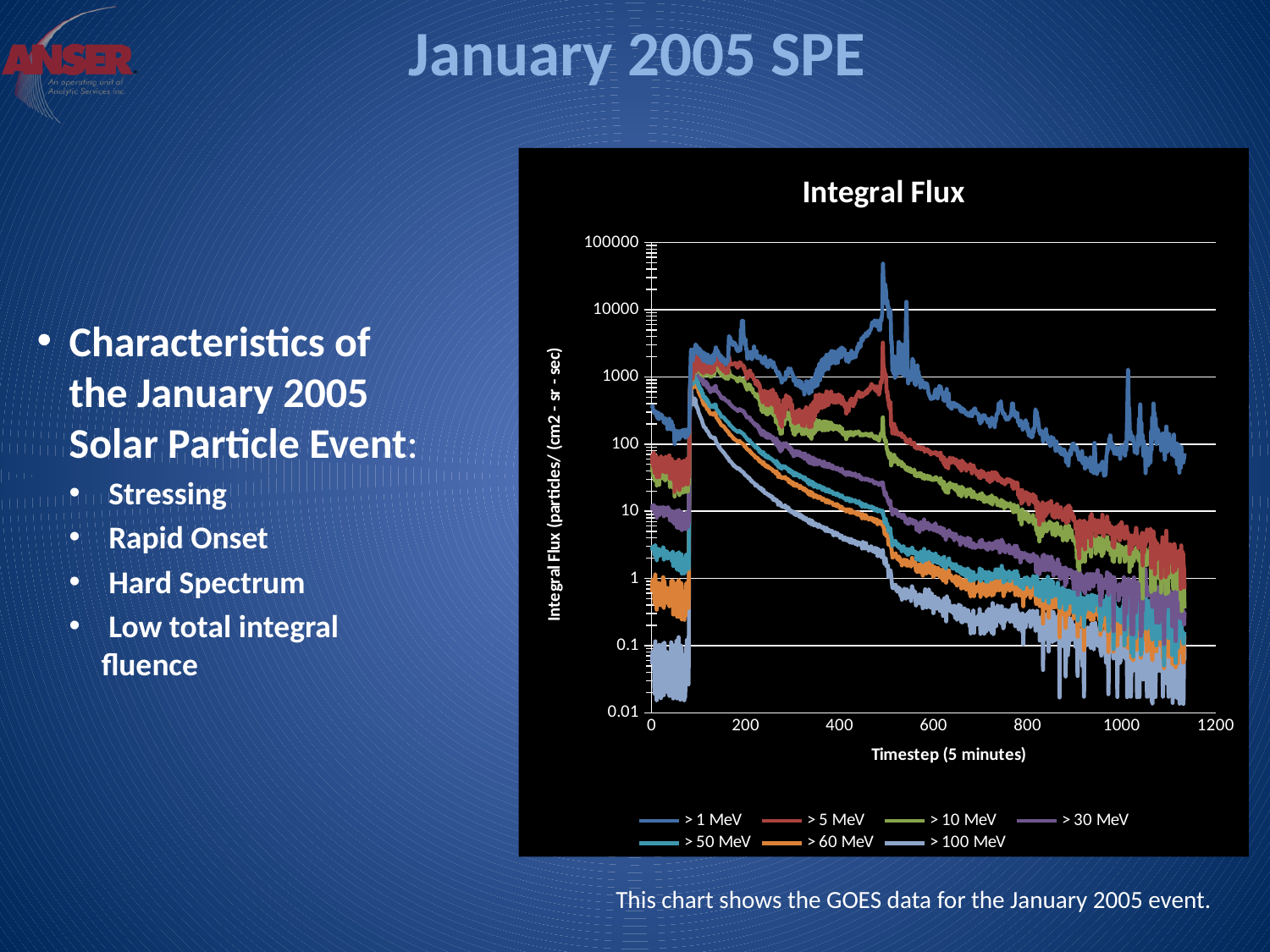
What kind of chart is shown on the slide? line chart Which series in the Integral Flux chart has the lowest values across the event? > 100 MeV Which series in the Integral Flux chart has the highest values across the event? > 1 MeV In the Integral Flux chart, is the value of the > 1 MeV series at timestep 200 greater or less than 1000? greater In the Integral Flux chart, is the value of the > 100 MeV series at timestep 1000 greater or less than 1? less What is the title of the chart on the slide? Integral Flux How many series does the legend of the Integral Flux chart list? 7 In the Integral Flux chart, is the value of the > 5 MeV series at timestep 600 greater or less than 10? greater What is the highest tick value shown on the y-axis of the Integral Flux chart? 100000 What is the x-axis label of the Integral Flux chart? Timestep (5 minutes) In the Integral Flux chart, at timestep 400, which series has the larger value: > 1 MeV or > 100 MeV? > 1 MeV In the Integral Flux chart, after the sharp onset near timestep 100, do the > 100 MeV values generally rise or fall as the timestep increases? fall